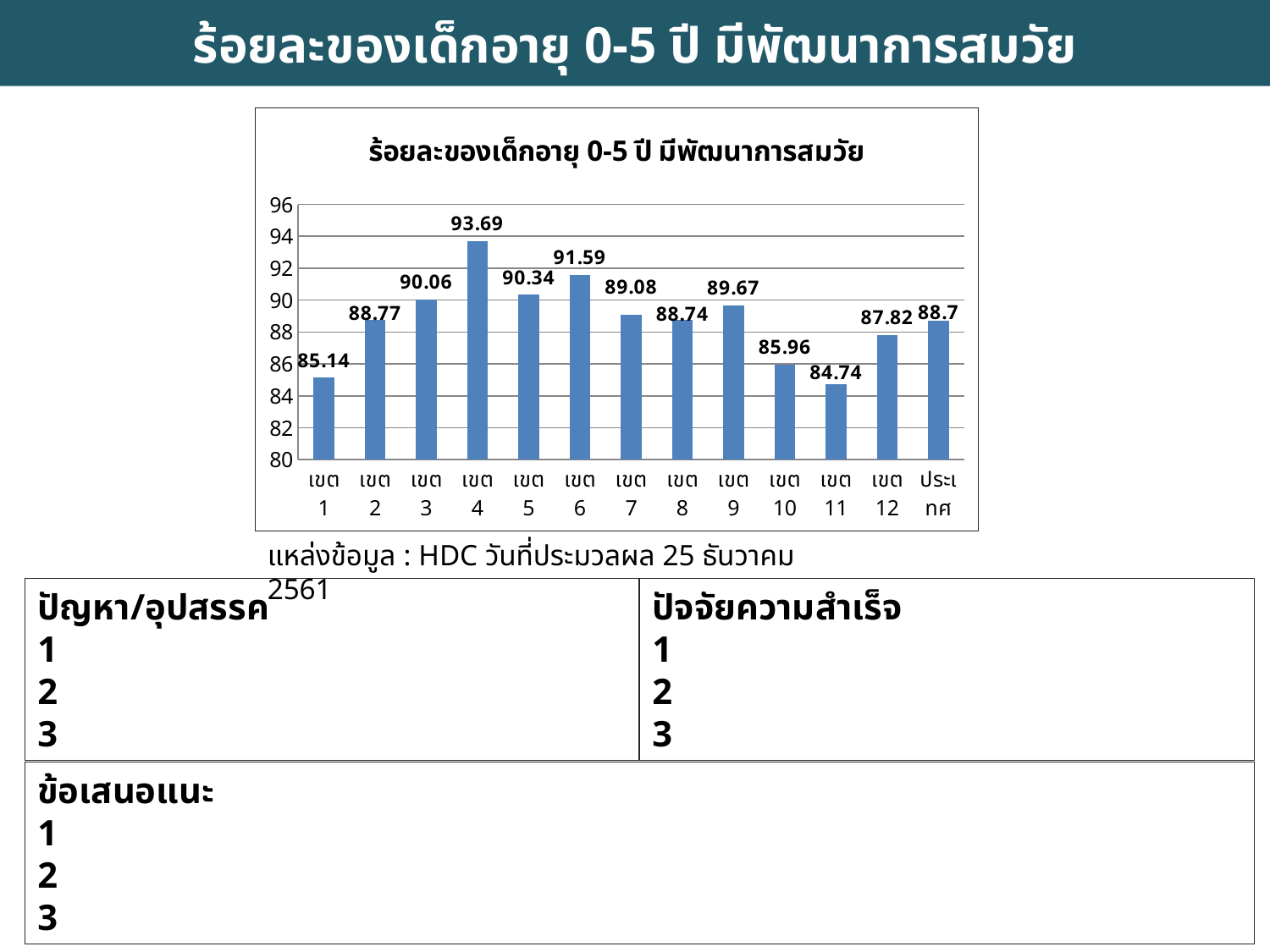
What is the difference between the values for เขต 6 and เขต 1? 6.45 What is the title of the chart? ร้อยละของเด็กอายุ 0-5 ปี มีพัฒนาการสมวัย Which is larger, the value for เขต 3 or the value for เขต 12? เขต 3 Which category has the lowest value? เขต 11 What is the value for ประเทศ? 88.7 What is the difference between the values for เขต 4 and เขต 11? 8.95 How many categories are shown on the x axis? 13 What kind of chart is shown on the slide? bar chart What is the value for เขต 10? 85.96 Which category has the highest value? เขต 4 What is the value for เขต 4? 93.69 Is the value for เขต 6 greater or less than 90? greater